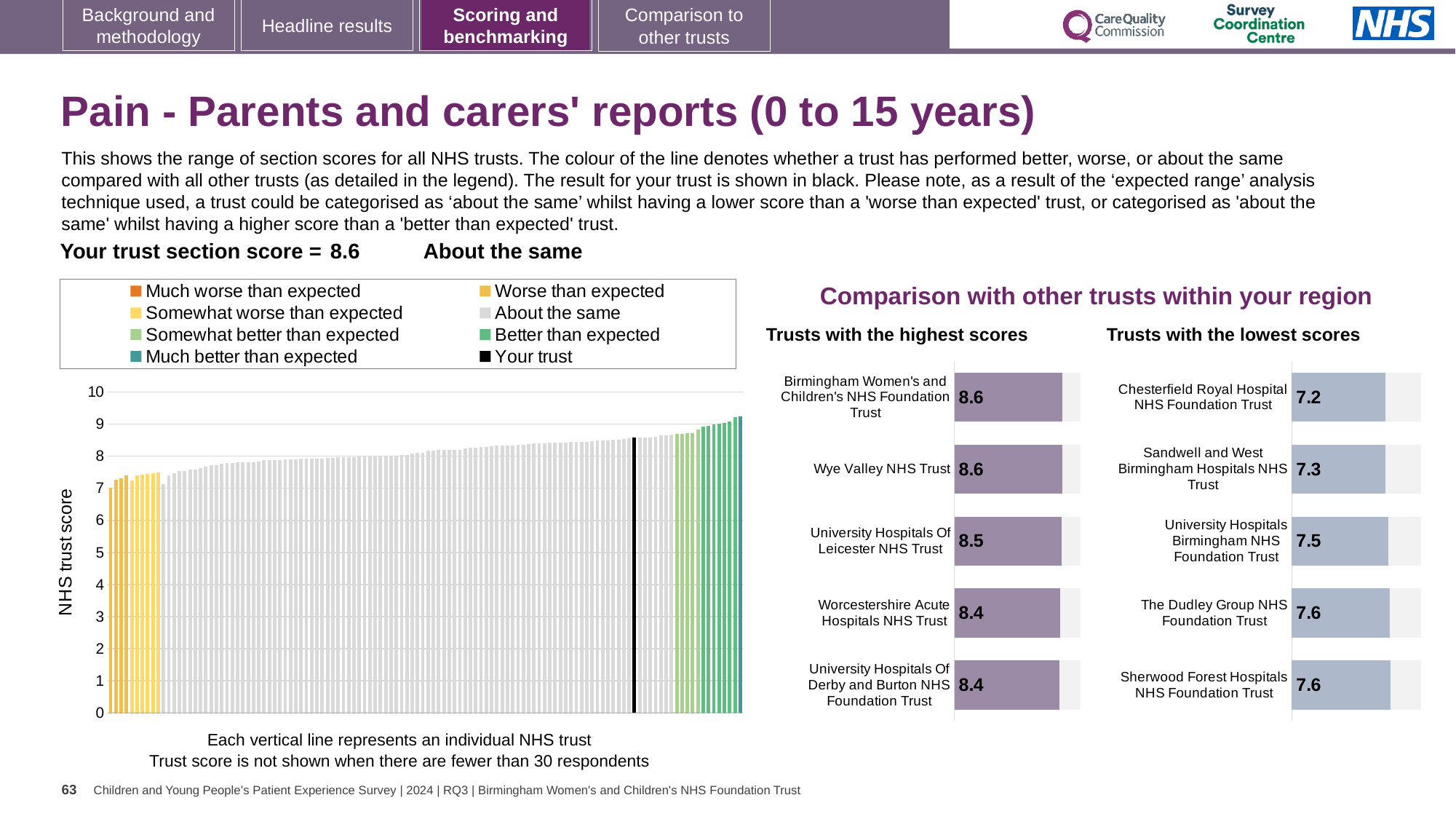
In the 'Trusts with the lowest scores' chart, which trust has the lowest score? Chesterfield Royal Hospital NHS Foundation Trust In the main NHS trust score chart, is the value of the black bar (your trust) greater or less than 8? greater In the 'Trusts with the highest scores' chart, what is the score for Wye Valley NHS Trust? 8.6 In the 'Trusts with the highest scores' chart, what is the score for University Hospitals Of Leicester NHS Trust? 8.5 In the 'Trusts with the lowest scores' chart, what is the difference between the scores of The Dudley Group NHS Foundation Trust and Chesterfield Royal Hospital NHS Foundation Trust? 0.4 In the 'Trusts with the lowest scores' chart, what is the score for Chesterfield Royal Hospital NHS Foundation Trust? 7.2 In the main NHS trust score chart, do the bar values rise or fall from left to right? Rise How many trusts are shown in the 'Trusts with the highest scores' chart? 5 In the 'Trusts with the highest scores' chart, what is the difference between the scores of Birmingham Women's and Children's NHS Foundation Trust and Worcestershire Acute Hospitals NHS Trust? 0.2 How many entries does the legend of the main NHS trust score chart list? 8 What kind of chart is the main chart showing the range of NHS trust scores? Bar chart In the 'Trusts with the lowest scores' chart, which has the higher score: Sandwell and West Birmingham Hospitals NHS Trust or University Hospitals Birmingham NHS Foundation Trust? University Hospitals Birmingham NHS Foundation Trust